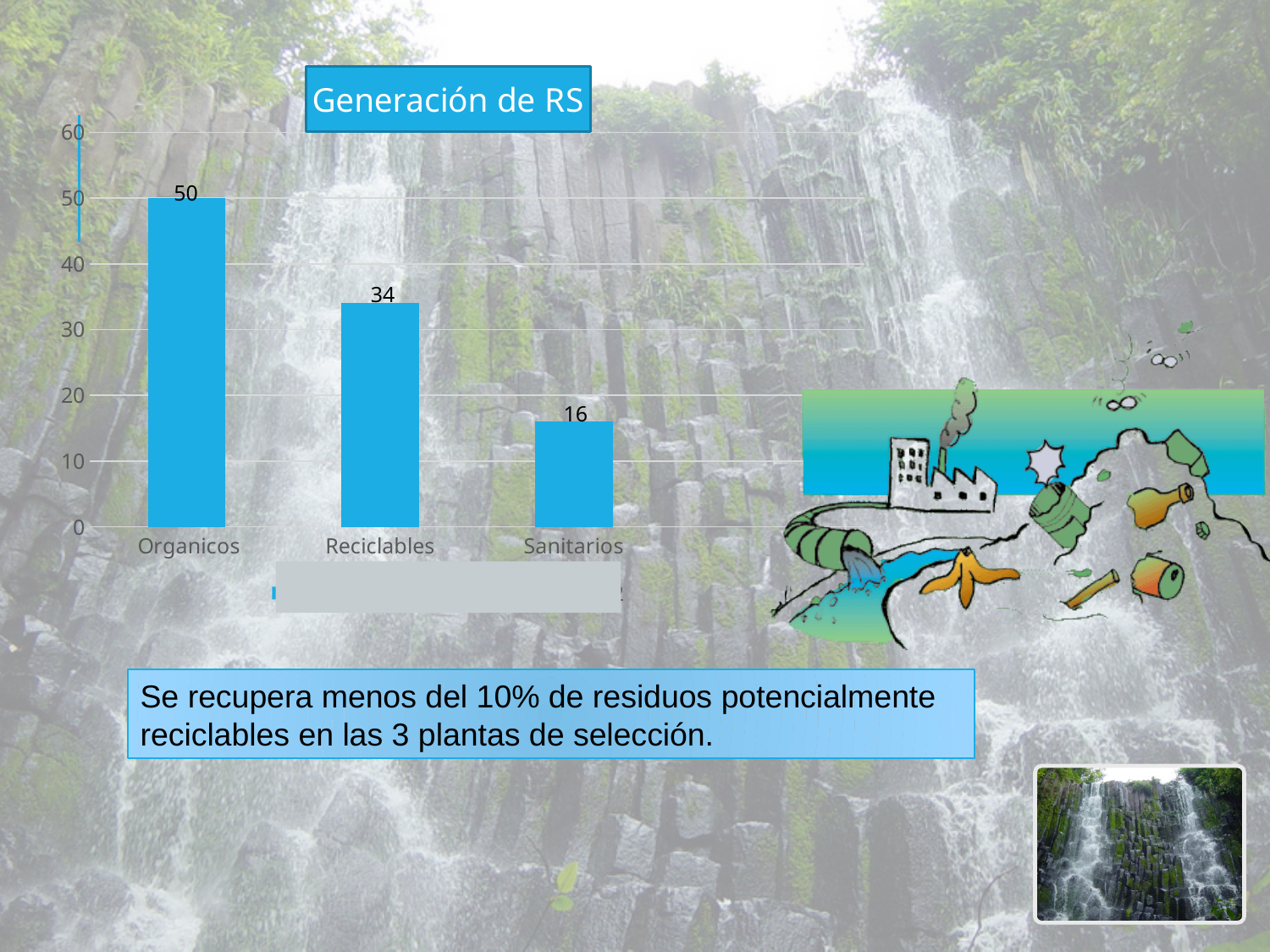
Which is larger, the value for Reciclables or the value for Sanitarios? Reciclables What is the value for Sanitarios? 16 Which category has the lowest value? Sanitarios What is the value for Organicos? 50 How many categories are shown on the x axis? 3 What is the difference between the values for Reciclables and Sanitarios? 18 What kind of chart is shown on the slide? bar chart Is the value for Reciclables greater or less than 30? greater What is the title of the chart? Generación de RS Which category has the highest value? Organicos What is the difference between the values for Organicos and Reciclables? 16 What is the value for Reciclables? 34